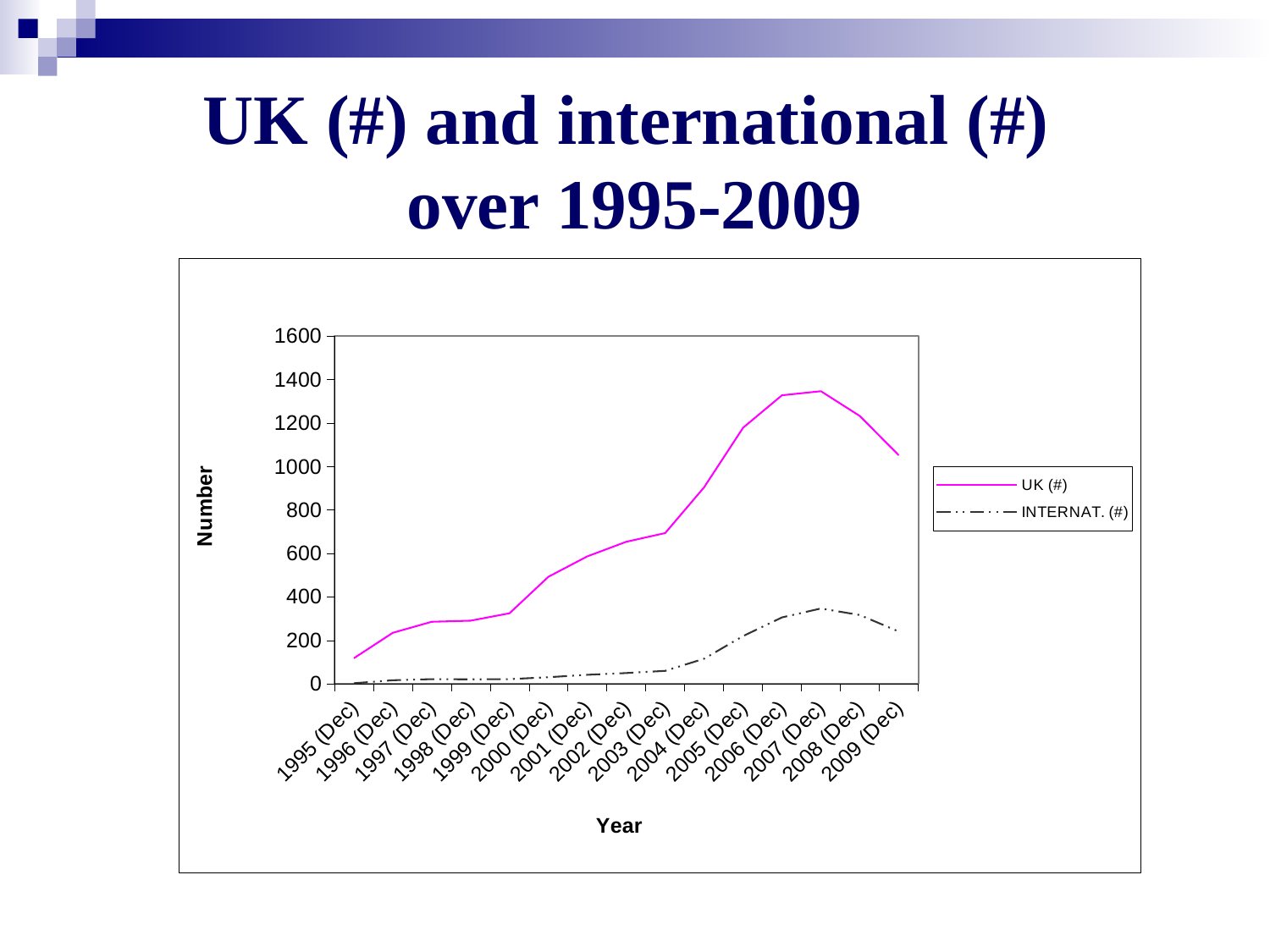
Is the value for UK (#) in 2000 (Dec) greater or less than 600? less What is the title of the vertical axis? Number Does the UK (#) line rise or fall between 1995 (Dec) and 2006 (Dec)? Rise Is the value for INTERNAT. (#) in 2003 (Dec) greater or less than 200? less Is the value for UK (#) in 1995 (Dec) greater or less than 200? less Which series is higher in 2007 (Dec), UK (#) or INTERNAT. (#)? UK (#) What kind of chart is shown on the slide? Line chart How many series does the legend list? 2 How many years (data points) are plotted along the x axis? 15 Does the INTERNAT. (#) line rise or fall between 2007 (Dec) and 2009 (Dec)? Fall